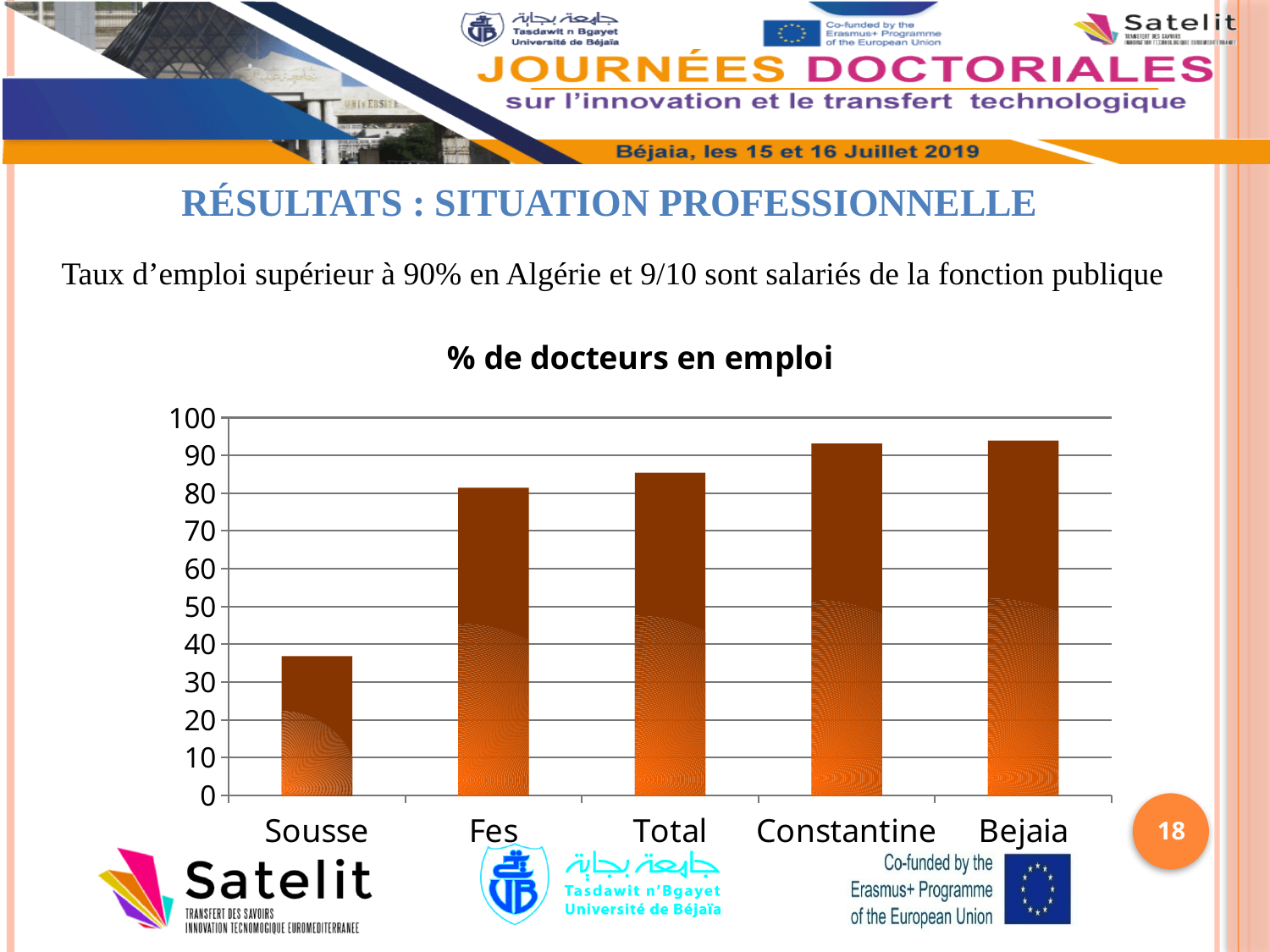
Is the value for Sousse greater or less than 40? less Which has a larger value, Fes or Sousse? Fes What is the title of the chart? % de docteurs en emploi What kind of chart is shown on the slide? bar chart Which category has the lowest value in the chart? Sousse Is the value for Bejaia greater or less than 90? greater Which has a larger value, Constantine or Fes? Constantine Is the value for Fes greater or less than 90? less How many categories are shown on the x axis of the chart? 5 Do the values rise or fall from left to right along the x axis? rise